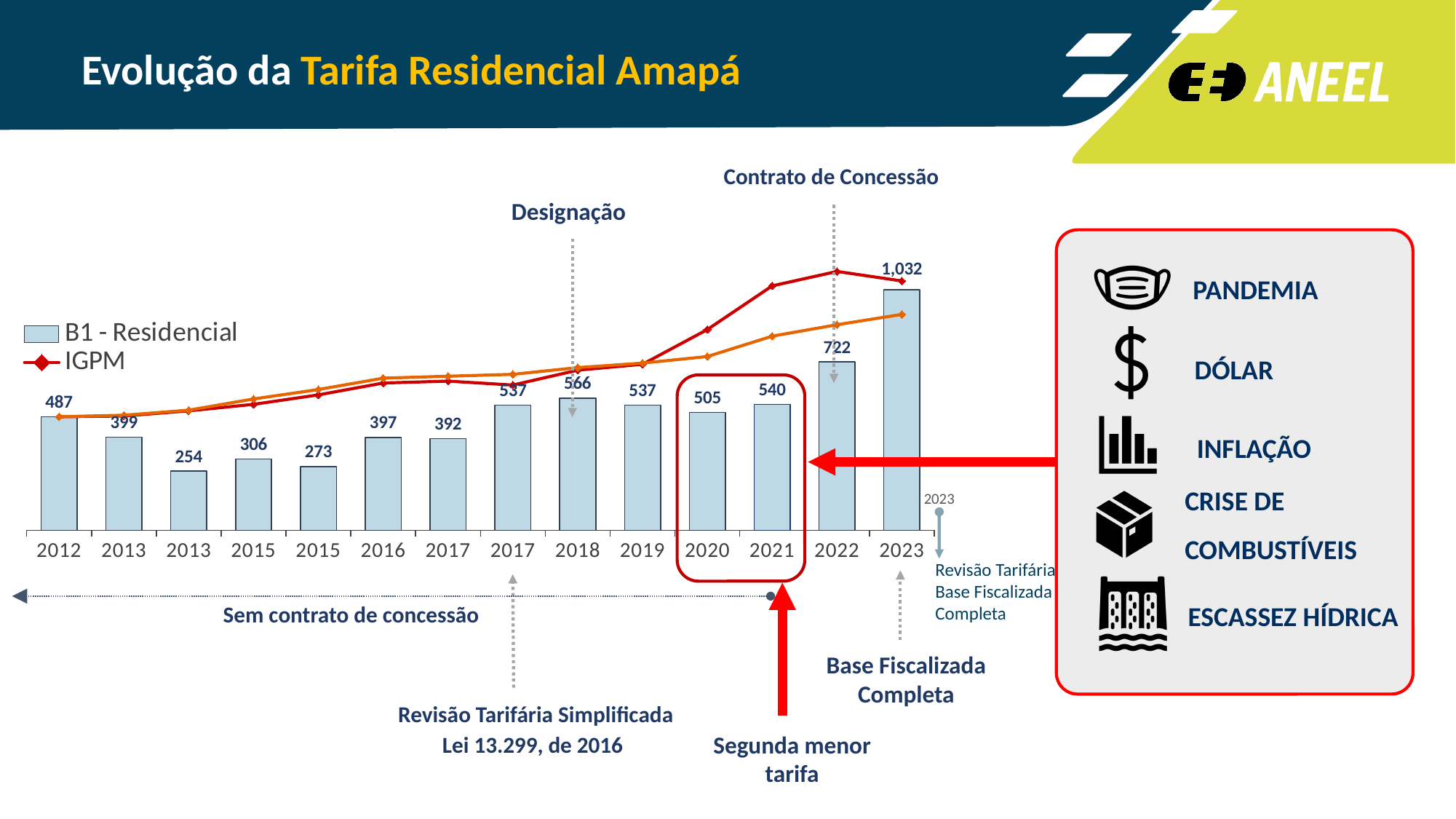
What is the lowest value shown on any B1 - Residencial bar? 254 How many bars are plotted in the chart? 14 How many series does the legend list? 2 What is the difference between the B1 - Residencial values for 2023 and 2022? 310 Which year has the highest B1 - Residencial bar? 2023 What is the value of the B1 - Residencial bar for 2020? 505 Which year has the larger B1 - Residencial value, 2018 or 2019? 2018 What is the value of the B1 - Residencial bar for 2012? 487 What is the difference between the B1 - Residencial values for 2021 and 2020? 35 Do the B1 - Residencial bars rise or fall from 2020 to 2023? rise What is the value of the B1 - Residencial bar for 2023? 1,032 What is the value of the B1 - Residencial bar for 2022? 722